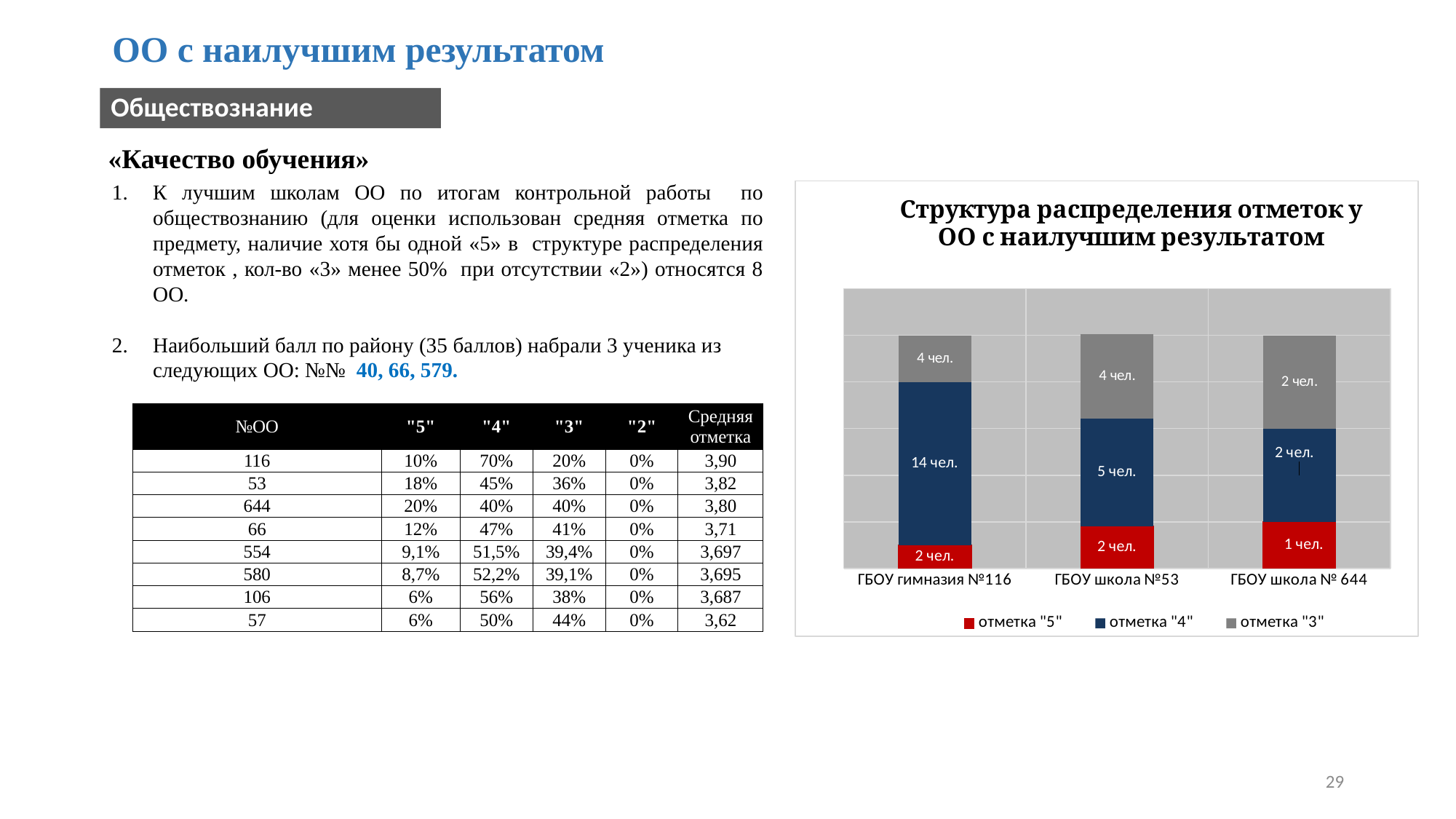
What is the title of the chart? Структура распределения отметок у ОО с наилучшим результатом How many pupils received отметка "3" at ГБОУ школа № 644? 2 чел. How many pupils received отметка "4" at ГБОУ гимназия №116? 14 чел. Which school has the lowest number of pupils with отметка "5"? ГБОУ школа № 644 What is the difference between the number of pupils with отметка "4" at ГБОУ гимназия №116 and at ГБОУ школа №53? 9 чел. What kind of chart is shown on the slide? stacked bar chart Which school has the highest number of pupils with отметка "4"? ГБОУ гимназия №116 How many schools (categories) are shown on the chart's x axis? 3 How many series does the chart legend list? 3 Which is larger: the number of pupils with отметка "3" at ГБОУ гимназия №116 or at ГБОУ школа № 644? ГБОУ гимназия №116 What is the total number of pupils in the bar for ГБОУ школа №53? 11 чел. How many pupils received отметка "5" at ГБОУ школа №53? 2 чел.